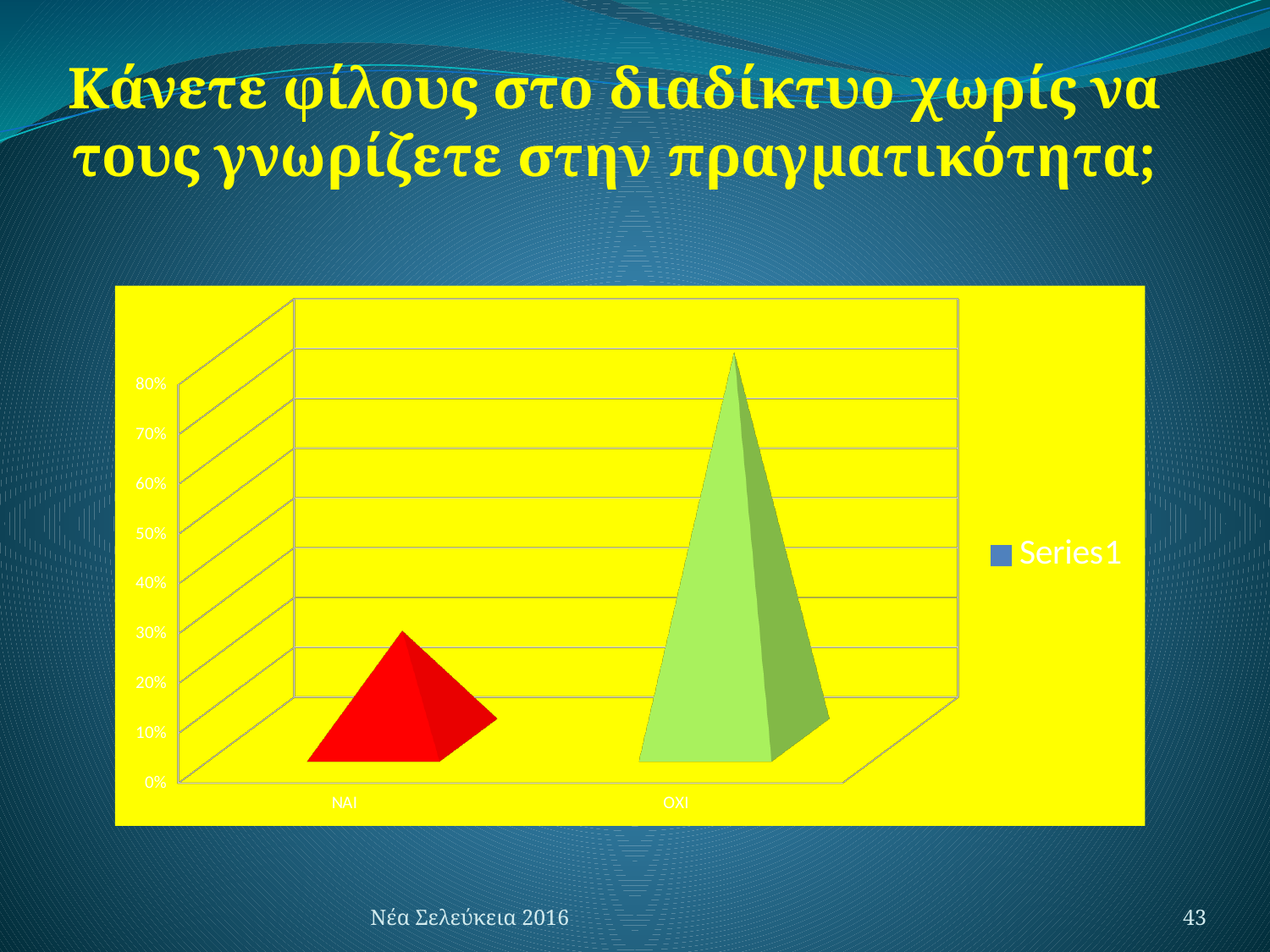
Which category has the lowest value in the chart? ΝΑΙ What kind of chart is shown on the slide? bar chart What colour is the bar for ΝΑΙ? red How many categories are shown on the x axis of the chart? 2 What is the name of the series listed in the chart legend? Series1 Which is larger, the value for ΝΑΙ or the value for ΟΧΙ? ΟΧΙ Is the value for ΟΧΙ greater or less than 50%? greater Is the value for ΝΑΙ greater or less than 40%? less Is the value for ΟΧΙ greater or less than 60%? greater How many series does the chart legend list? 1 Which category has the highest value in the chart? ΟΧΙ